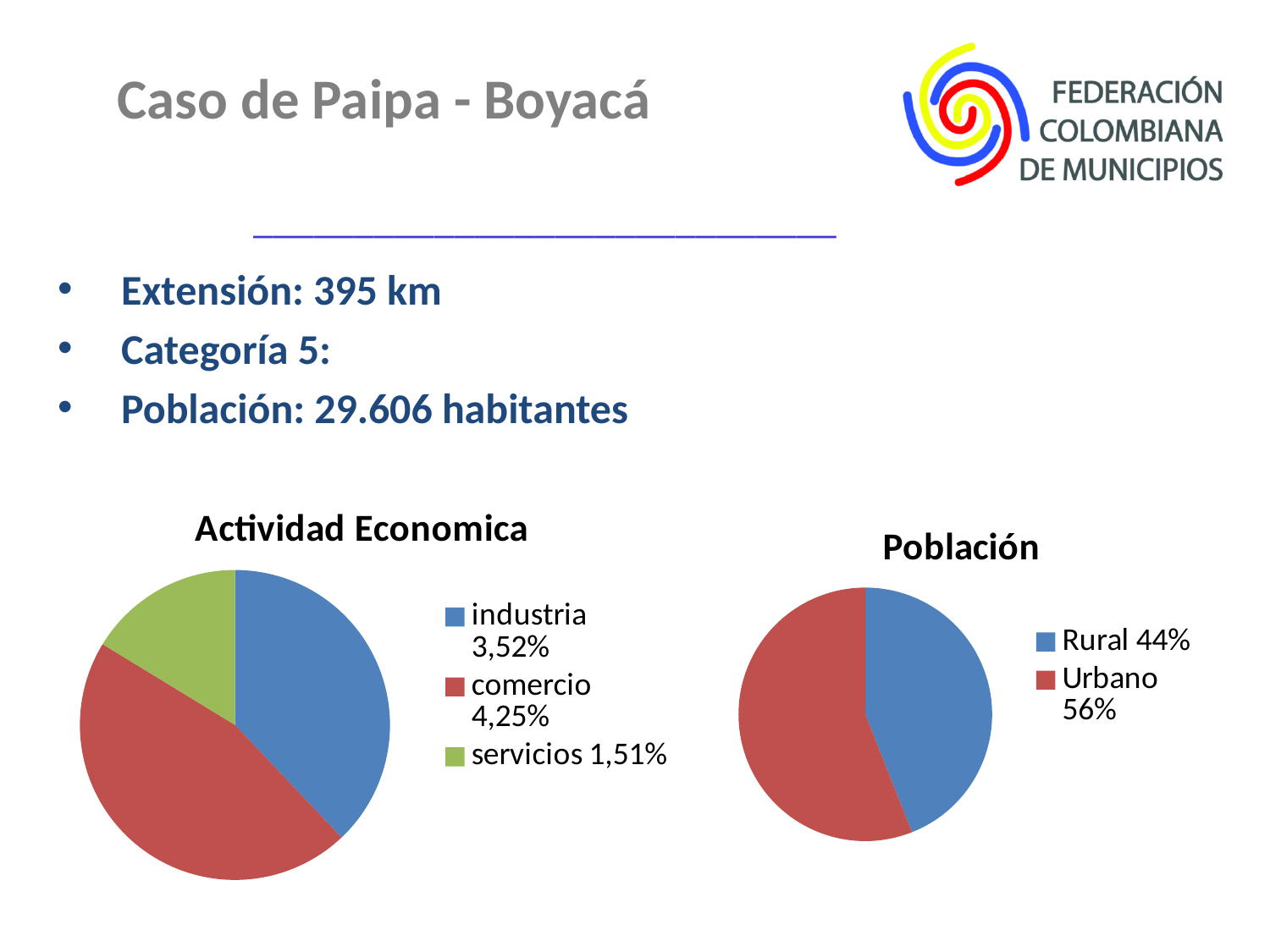
In the Actividad Economica chart, what value is shown for industria? 3,52% In the Población chart, what is the difference between Urbano and Rural? 12% In the Actividad Economica chart, what value is shown for comercio? 4,25% In the Actividad Economica chart, which category has the largest slice? comercio In the Actividad Economica chart, which category has the smallest slice? servicios In the Población chart, what value is shown for Rural? 44% What kind of chart is the Población chart? Pie chart In the Población chart, which is larger, Rural or Urbano? Urbano In the Actividad Economica chart, what value is shown for servicios? 1,51% In the Población chart, what share of the pie is Urbano? 56% In the Actividad Economica chart, how many categories are shown? 3 In the Actividad Economica chart, what is the difference between the values for comercio and industria? 0,73%